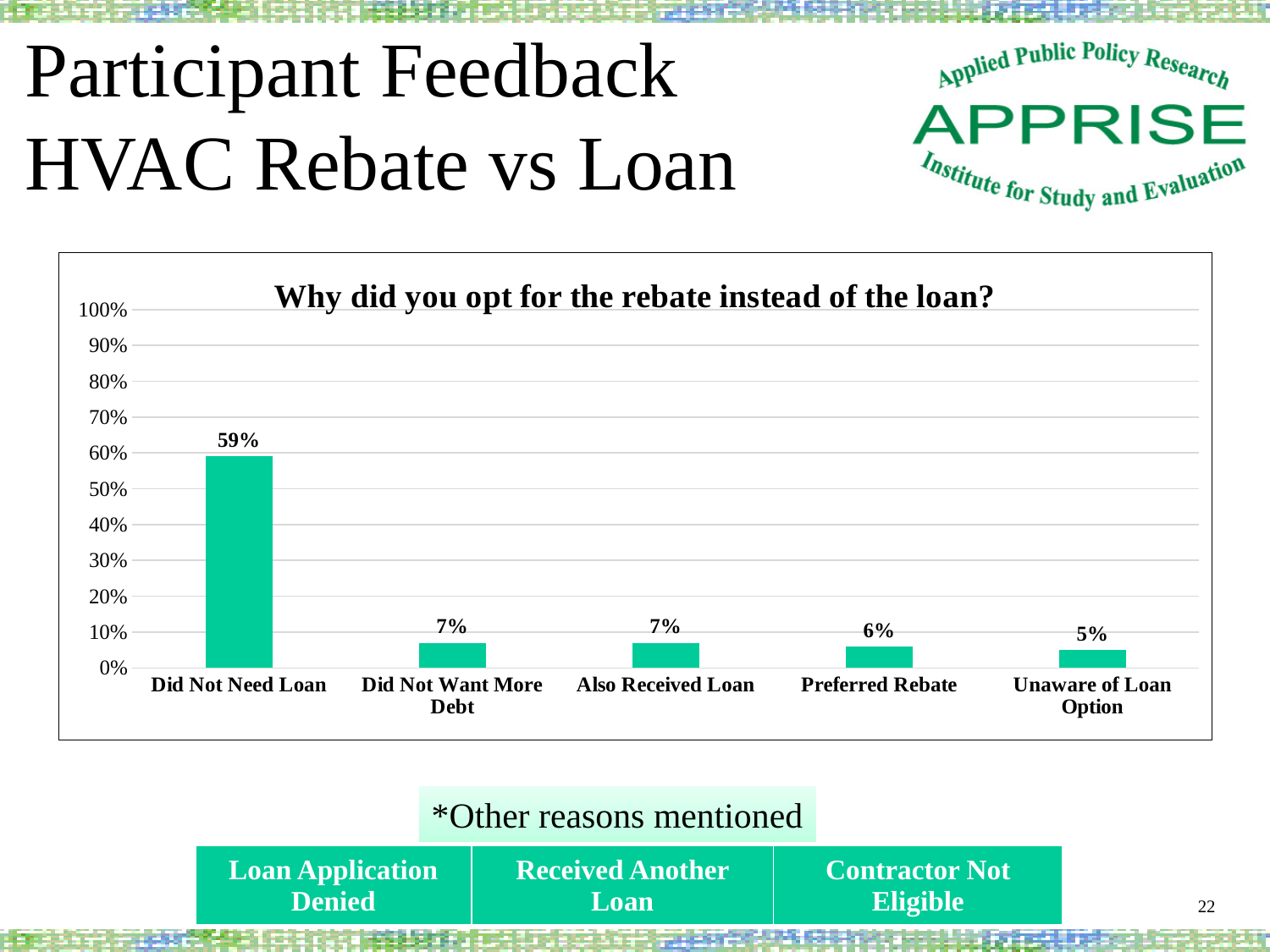
What kind of chart is shown? bar chart Which category has the lowest value? Unaware of Loan Option What is the difference between the values for Did Not Need Loan and Did Not Want More Debt? 52% Which category has the highest value? Did Not Need Loan What is the value for Unaware of Loan Option? 5% How many categories are shown on the x axis? 5 What is the title of the chart? Why did you opt for the rebate instead of the loan? Is the value for Did Not Need Loan greater or less than 50%? greater What is the value for Preferred Rebate? 6% What is the difference between the values for Preferred Rebate and Unaware of Loan Option? 1% Which is larger, the value for Did Not Need Loan or the value for Also Received Loan? Did Not Need Loan What is the value for Did Not Need Loan? 59%